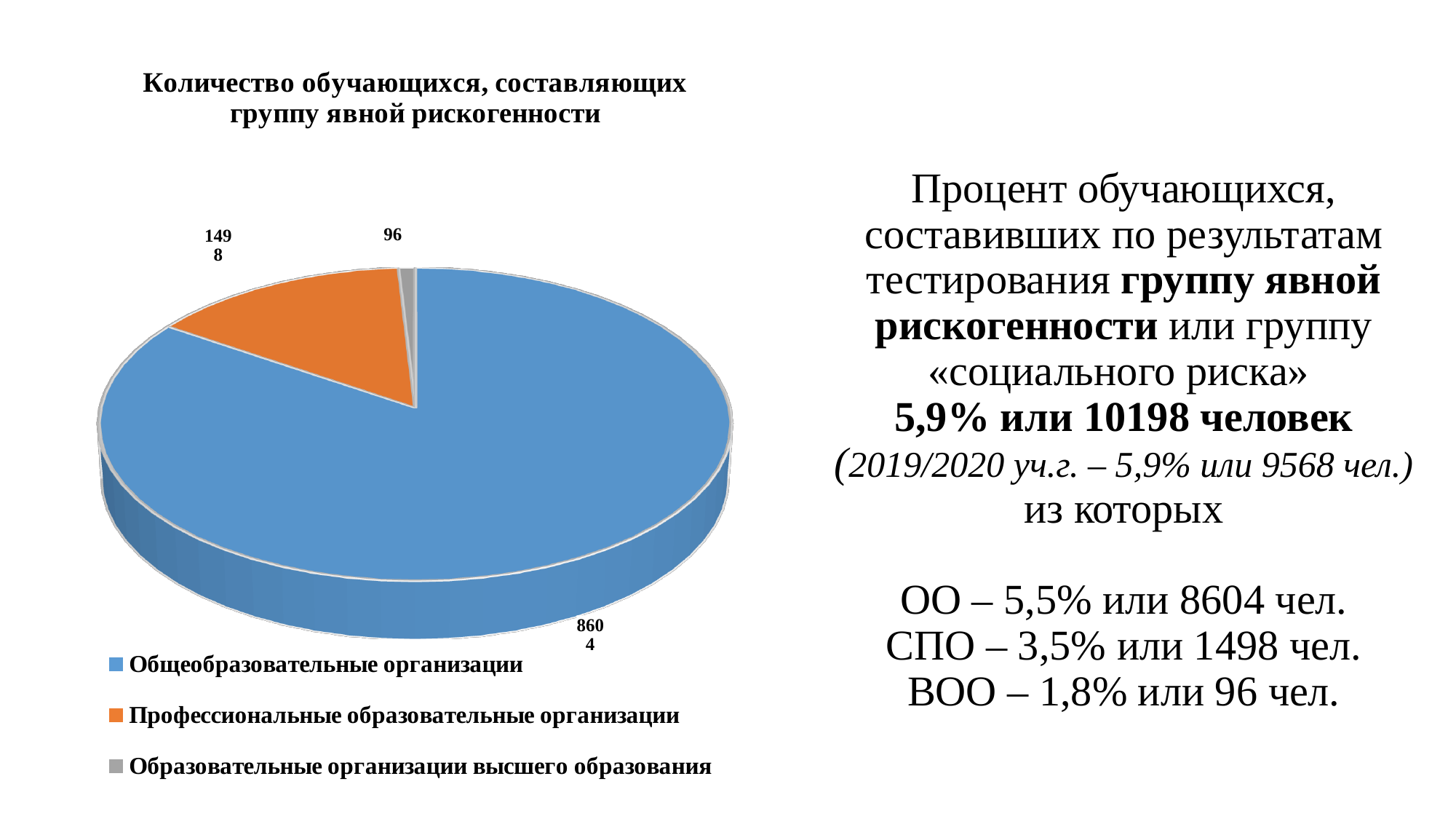
What is the value for Общеобразовательные организации? 8604 What is the difference between the values for Профессиональные образовательные организации and Образовательные организации высшего образования? 1402 Which category has the smallest slice of the pie? Образовательные организации высшего образования How many slices does the pie chart have? 3 What is the value for Образовательные организации высшего образования? 96 Which is larger: the value for Профессиональные образовательные организации or the value for Образовательные организации высшего образования? Профессиональные образовательные организации What type of chart is shown on the slide? Pie chart Which category has the largest slice of the pie? Общеобразовательные организации What is the title of the chart? Количество обучающихся, составляющих группу явной рискогенности What is the value for Профессиональные образовательные организации? 1498 What is the difference between the values for Общеобразовательные организации and Профессиональные образовательные организации? 7106 What colour is the slice for Профессиональные образовательные организации? Orange